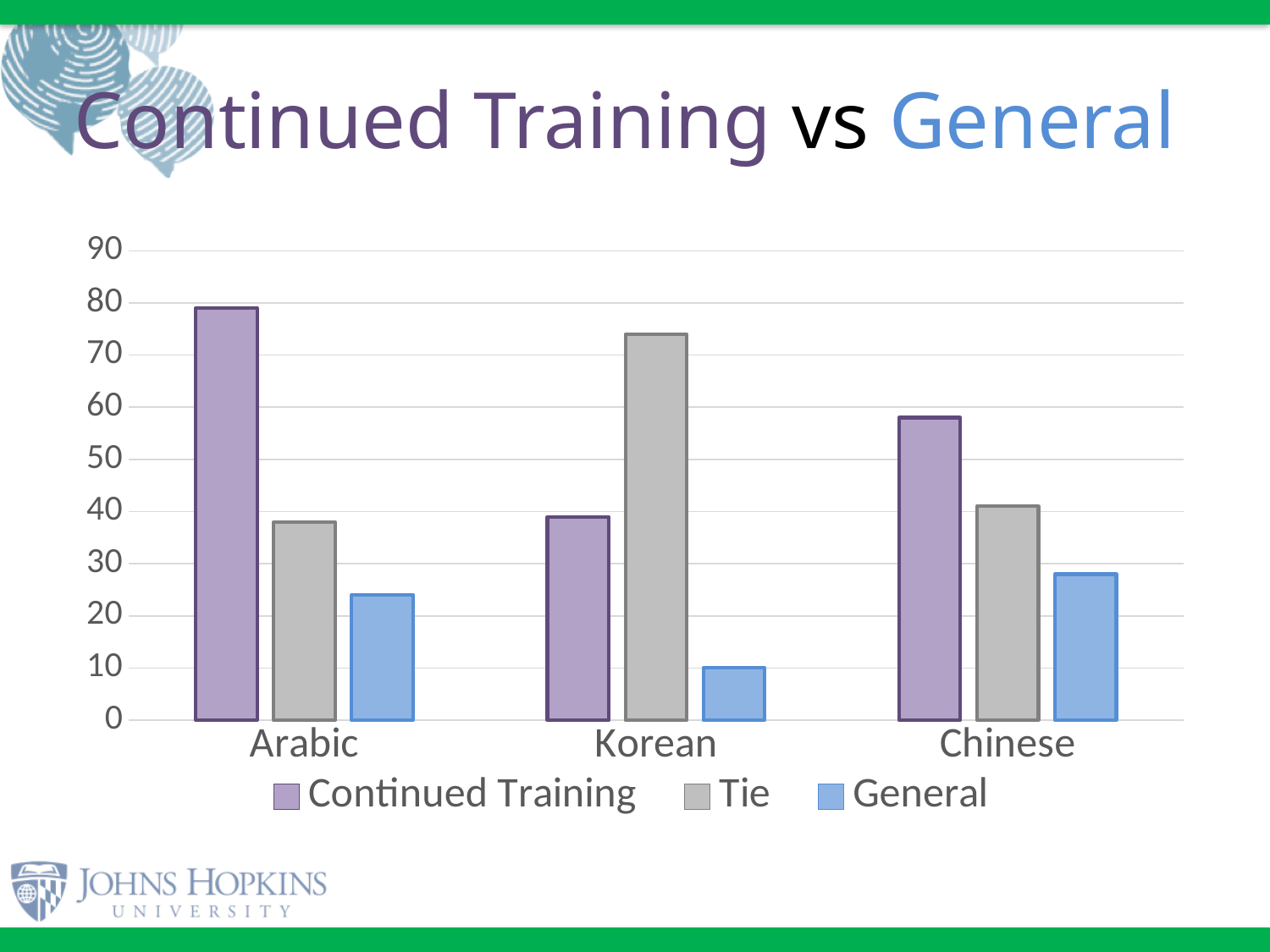
Which language has the highest Continued Training value? Arabic Is the Tie value for Chinese greater or less than 50? less What colour are the General bars? blue How many language categories are shown on the x axis? 3 Which language has the highest Tie value? Korean Which language has the lowest General value? Korean For Korean, which is larger: Continued Training or Tie? Tie Is the General value for Korean greater or less than 20? less Is the Continued Training value for Arabic greater or less than 70? greater What kind of chart is shown on the slide? bar chart For Chinese, which is larger: Continued Training or General? Continued Training How many series does the legend list? 3